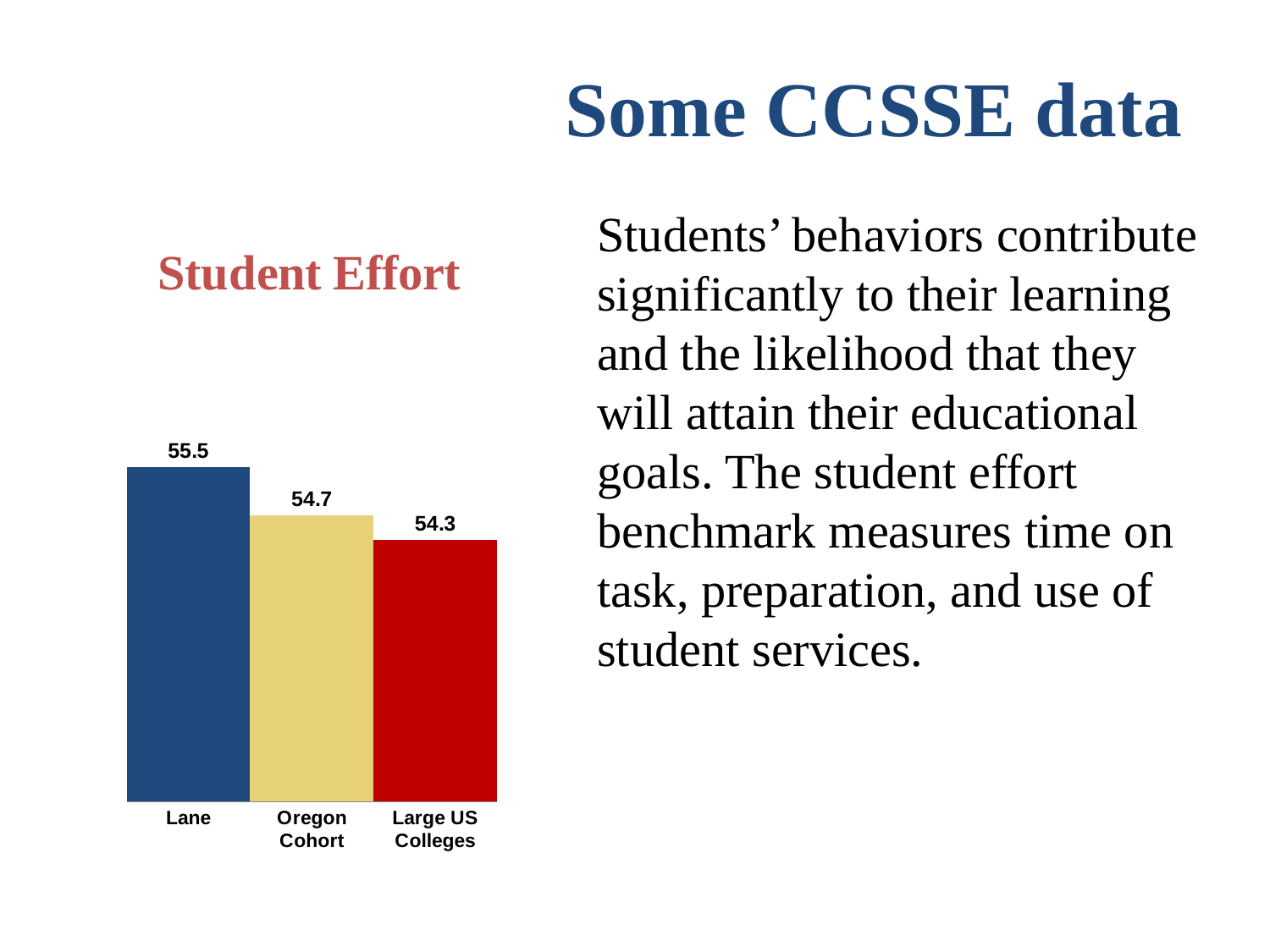
How many categories are shown in the Student Effort chart? 3 What is the Student Effort value for Large US Colleges? 54.3 Which category has the highest Student Effort value? Lane What is the title of the chart on the slide? Student Effort Which category has the lowest Student Effort value? Large US Colleges Do the values rise or fall from left to right across the Student Effort chart? fall What is the Student Effort value for Lane? 55.5 What is the difference between the Student Effort values for Lane and Large US Colleges? 1.2 What is the Student Effort value for the Oregon Cohort? 54.7 Which is larger, the Student Effort value for the Oregon Cohort or for Large US Colleges? Oregon Cohort What kind of chart is the Student Effort chart? bar chart What is the difference between the Student Effort values for Lane and the Oregon Cohort? 0.8